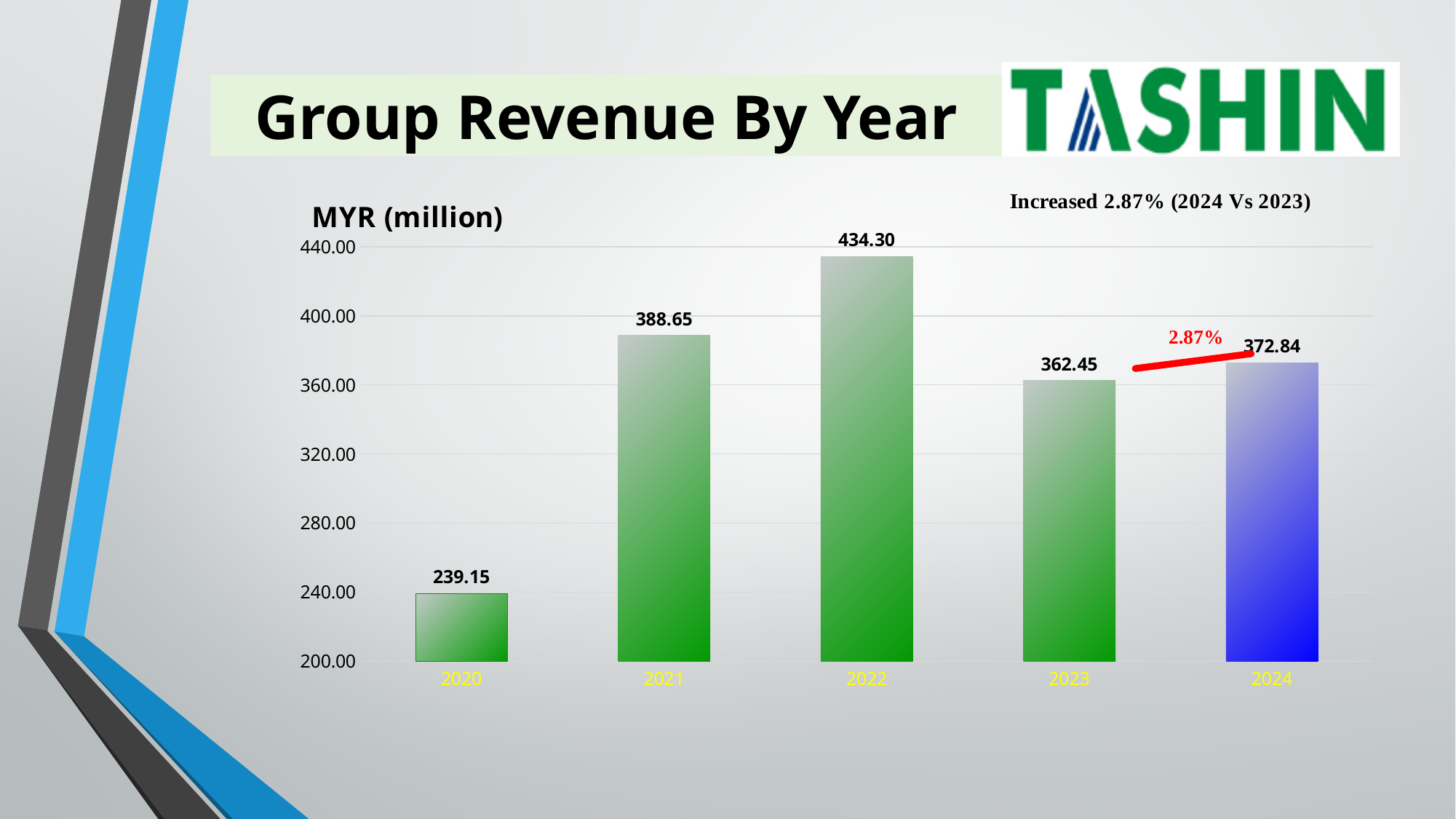
Which year has the highest group revenue? 2022 What is the group revenue for 2024? 372.84 Is the group revenue for 2021 greater or less than 400.00? less What is the group revenue for 2022? 434.30 What is the difference in group revenue between 2022 and 2021? 45.65 Which year has higher group revenue, 2021 or 2023? 2021 What kind of chart is shown on the slide? bar chart How many years are shown on the chart? 5 What percentage increase is shown for 2024 versus 2023? 2.87% Which year has the lowest group revenue? 2020 What is the group revenue for 2020? 239.15 What is the difference in group revenue between 2024 and 2023? 10.39